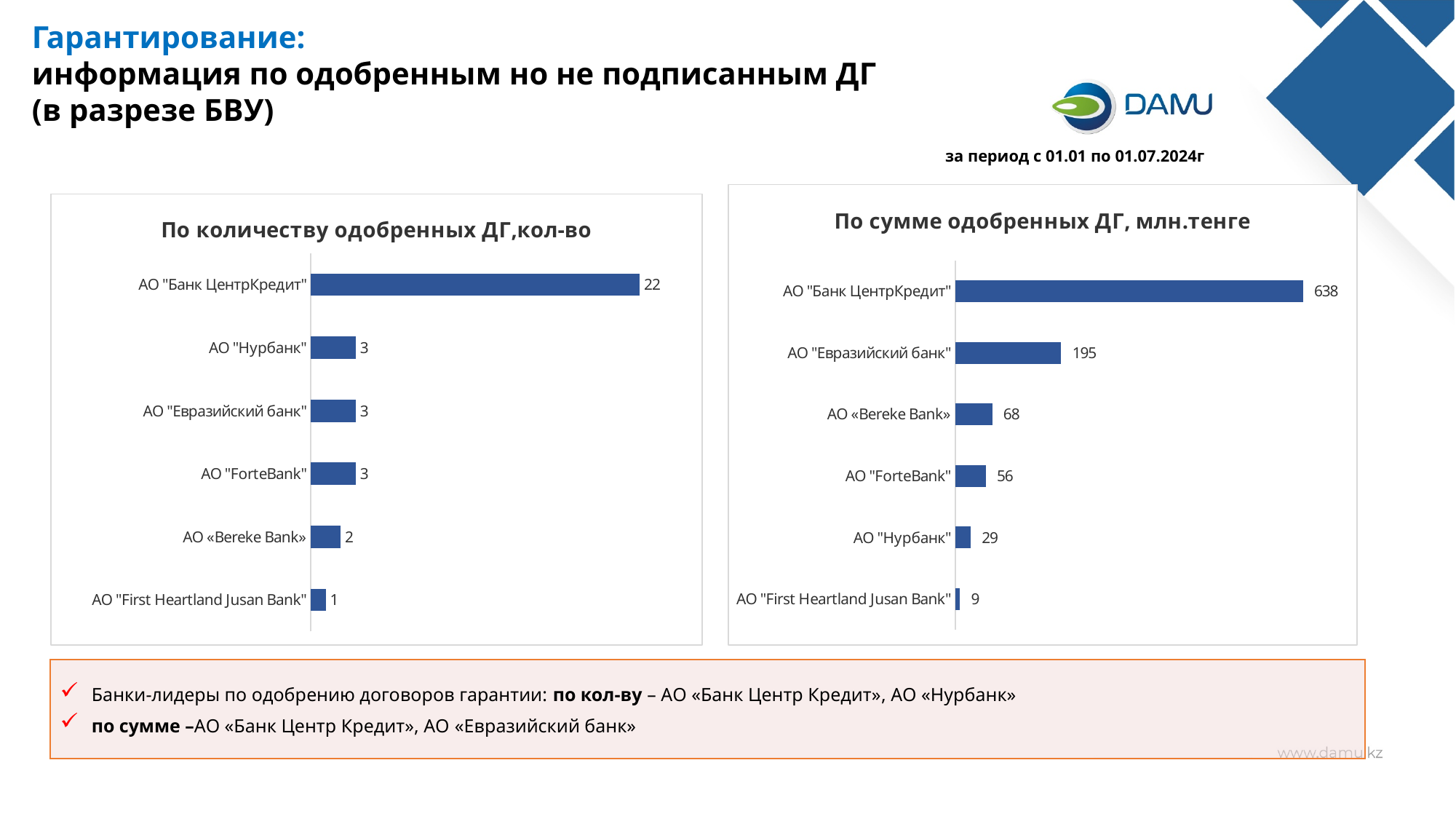
In the chart "По сумме одобренных ДГ, млн.тенге", what is the difference between АО "Банк ЦентрКредит" and АО "Евразийский банк"? 443 What type of chart is "По сумме одобренных ДГ, млн.тенге"? Bar chart In the chart "По сумме одобренных ДГ, млн.тенге", what is the value for АО "First Heartland Jusan Bank"? 9 In the chart "По количеству одобренных ДГ,кол-во", what is the value for АО "Банк ЦентрКредит"? 22 In the chart "По количеству одобренных ДГ,кол-во", which bank has the lowest value? АО "First Heartland Jusan Bank" In the chart "По сумме одобренных ДГ, млн.тенге", what is the value for АО «Bereke Bank»? 68 In the chart "По количеству одобренных ДГ,кол-во", what is the difference between АО "Банк ЦентрКредит" and АО "Нурбанк"? 19 In the chart "По сумме одобренных ДГ, млн.тенге", what is the value for АО "Евразийский банк"? 195 In the chart "По сумме одобренных ДГ, млн.тенге", which bank has the highest value? АО "Банк ЦентрКредит" In the chart "По сумме одобренных ДГ, млн.тенге", which is larger: АО "ForteBank" or АО "Нурбанк"? АО "ForteBank" What is the title of the chart on the left side of the slide? По количеству одобренных ДГ,кол-во How many banks are shown in the chart "По количеству одобренных ДГ,кол-во"? 6